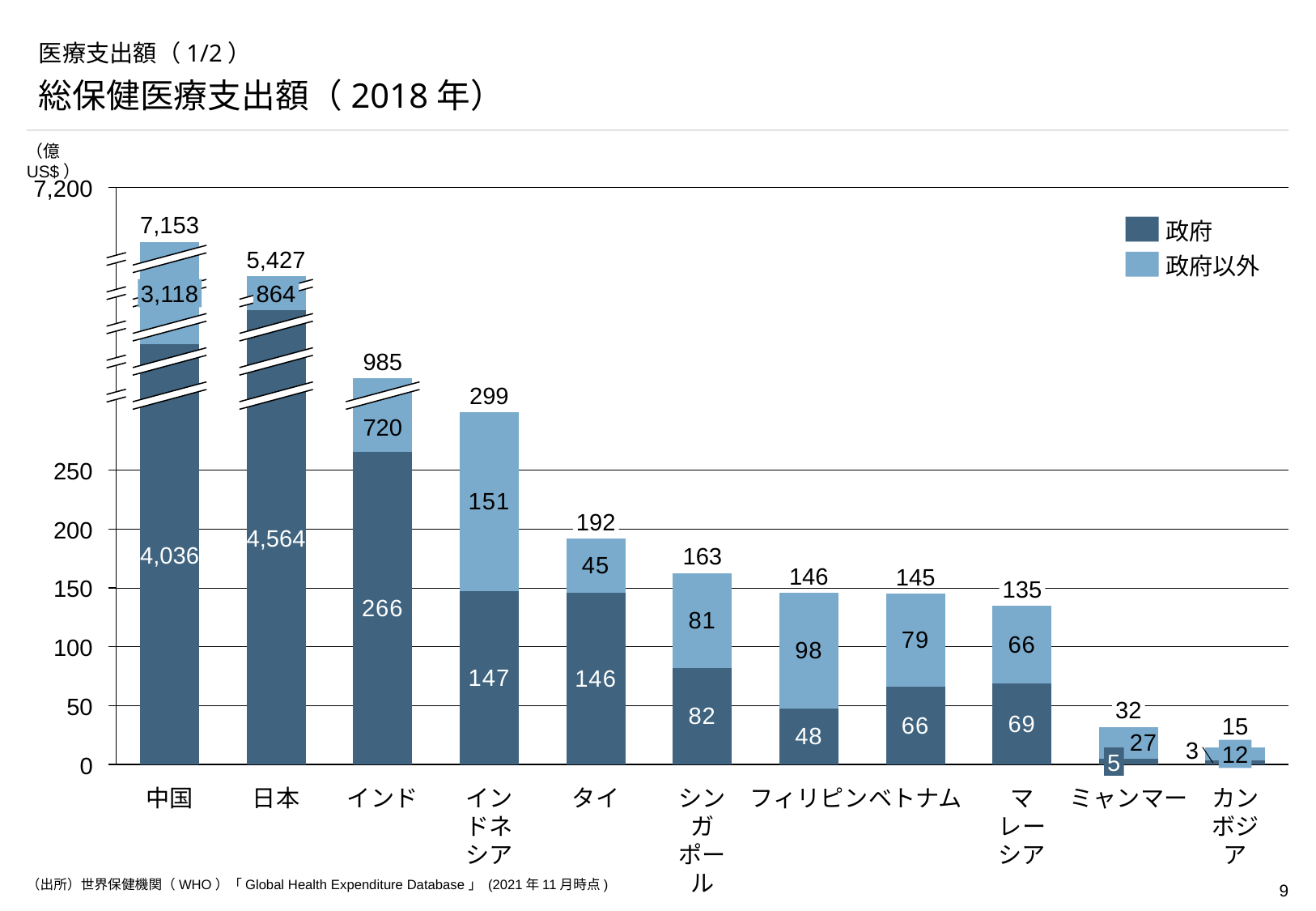
How many series does the legend list? 2 What is the 政府 value for フィリピン? 48 Which country has the highest total health expenditure? 中国 What kind of chart is shown on the slide? stacked bar chart Which is larger, the 政府以外 value for タイ or the 政府以外 value for シンガポール? シンガポール How many countries are shown on the x axis? 11 Which country has the lowest total health expenditure? カンボジア What is the total labeled above the bar for インドネシア? 299 What is the 政府以外 value for インド? 720 What are the two legend entries of the chart? 政府, 政府以外 What is the 政府 value for 日本? 4,564 What is the difference between the total for ミャンマー and the total for カンボジア? 17